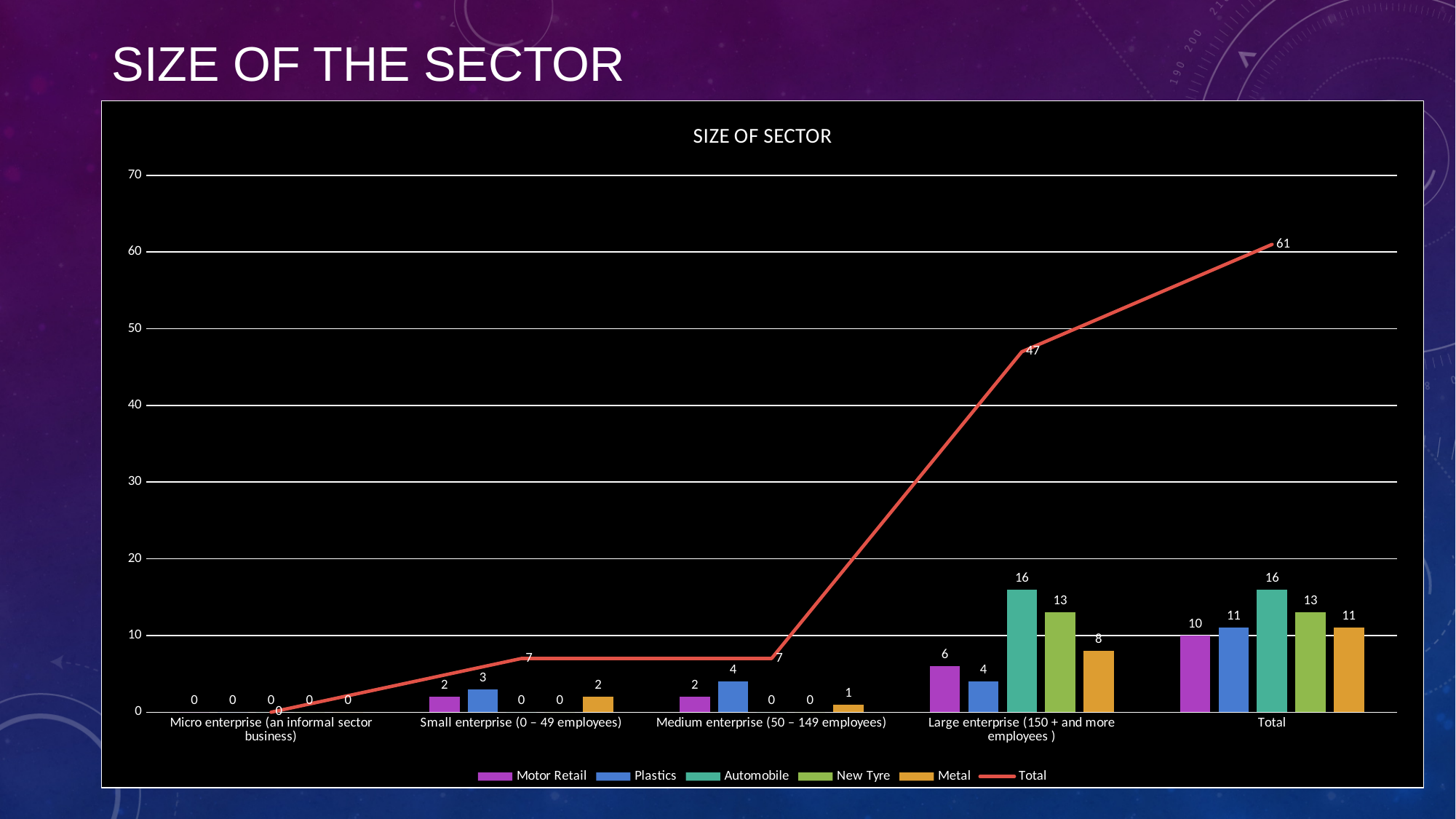
What is the title of the chart? SIZE OF SECTOR How many categories are shown on the x axis? 5 What is the difference between the Total line values for Total and Large enterprise (150 + and more employees)? 14 Which series has the lowest value in the Total category? Motor Retail Which category has the highest value on the Total line? Total What is the value of the Total line for Large enterprise (150 + and more employees)? 47 Does the Total line rise or fall from Medium enterprise (50 – 149 employees) to Large enterprise (150 + and more employees)? rise What is the Metal value in the Total category? 11 What is the Automobile value for Large enterprise (150 + and more employees)? 16 How many series does the legend list? 6 Which is larger for Large enterprise (150 + and more employees): Motor Retail or Metal? Metal What is the Plastics value for Medium enterprise (50 – 149 employees)? 4